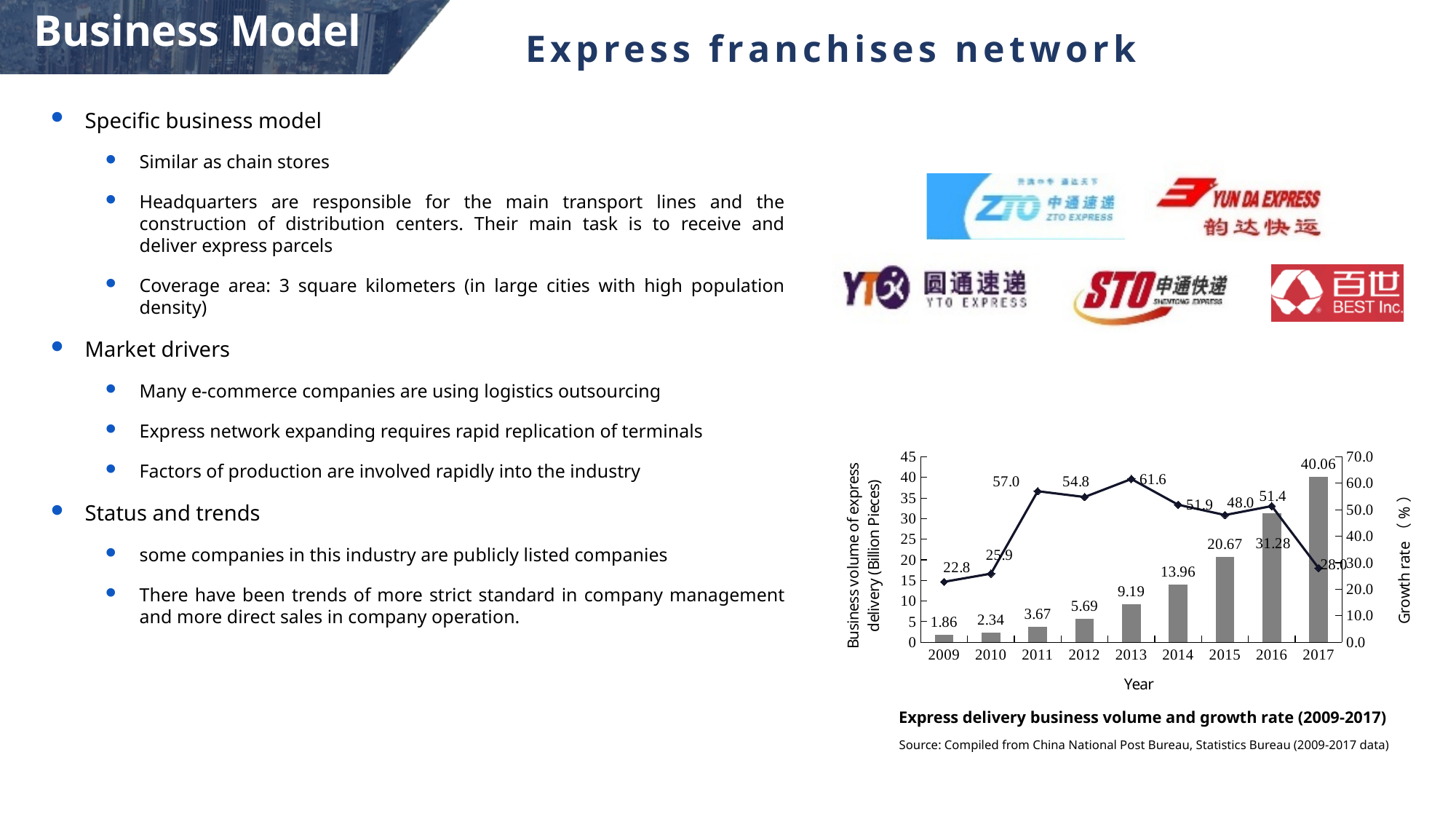
How many years are shown on the x axis of the chart? 9 Do the business volume bars rise or fall from 2009 to 2017? rise Which is larger, the growth rate in 2012 or in 2014? 2012 Which year has the highest growth rate? 2013 What is the business volume of express delivery in 2017? 40.06 What is the title of the chart? Express delivery business volume and growth rate (2009-2017) Which year has the lowest business volume of express delivery? 2009 What is the difference in business volume between 2016 and 2015? 10.61 What is the business volume of express delivery in 2013? 9.19 Is the growth rate for 2017 greater or less than 40.0? less What is the growth rate in 2015? 48.0 What is the growth rate in 2011? 57.0